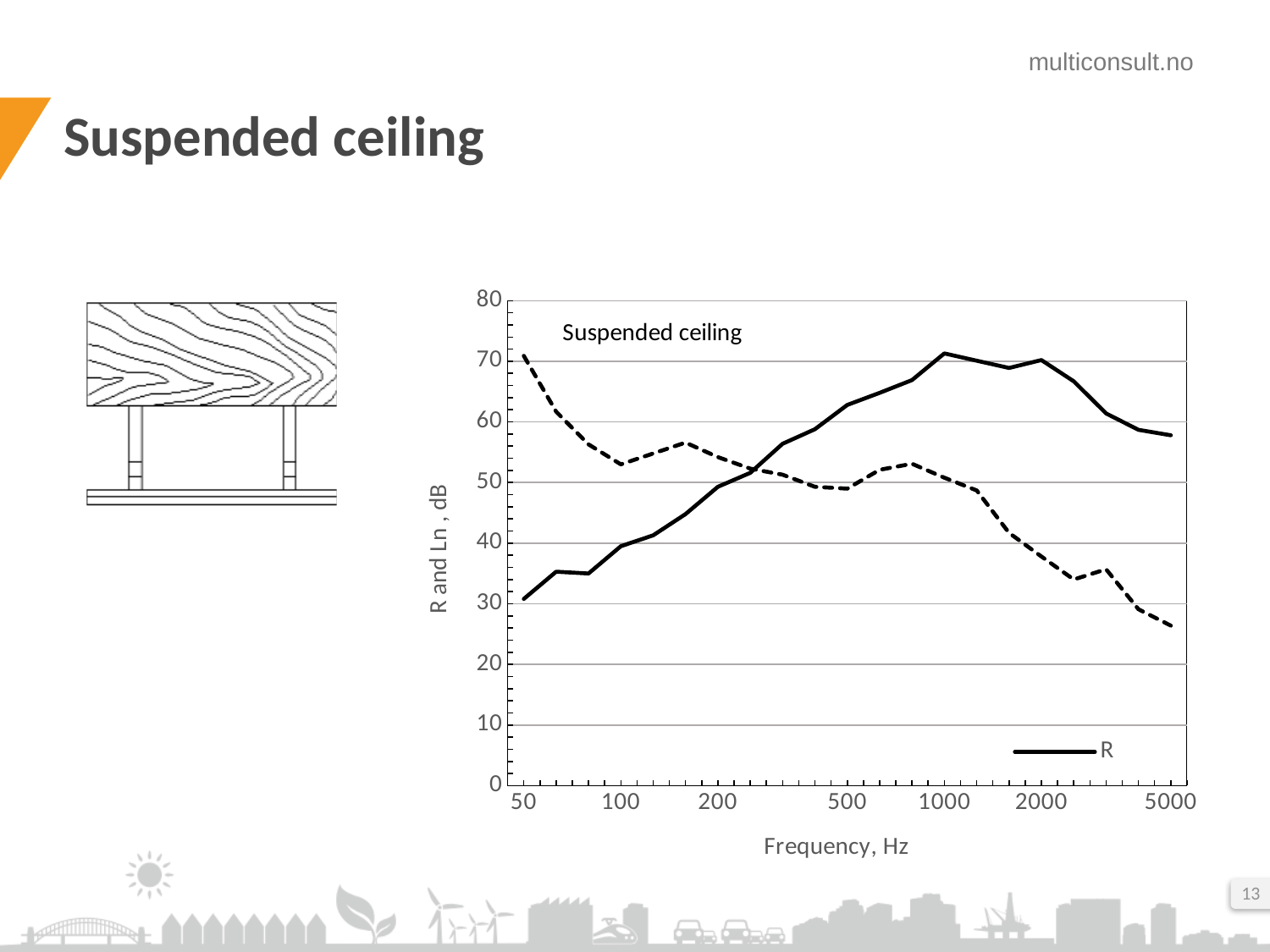
Is the value of the solid R line at 50 Hz greater or less than 40? less How many series does the chart legend list? 1 At 50 Hz, which line has the higher value, the solid R line or the dashed line? the dashed line Is the value of the dashed line at 50 Hz greater or less than 60? greater Does the solid R line rise or fall between 50 Hz and 1000 Hz? rise Is the value of the solid R line at 1000 Hz greater or less than 60? greater What is the title shown inside the chart? Suspended ceiling At 2000 Hz, which line has the higher value, the solid R line or the dashed line? the solid R line What is the label of the x axis of the chart? Frequency, Hz What kind of chart is shown on the slide? line chart